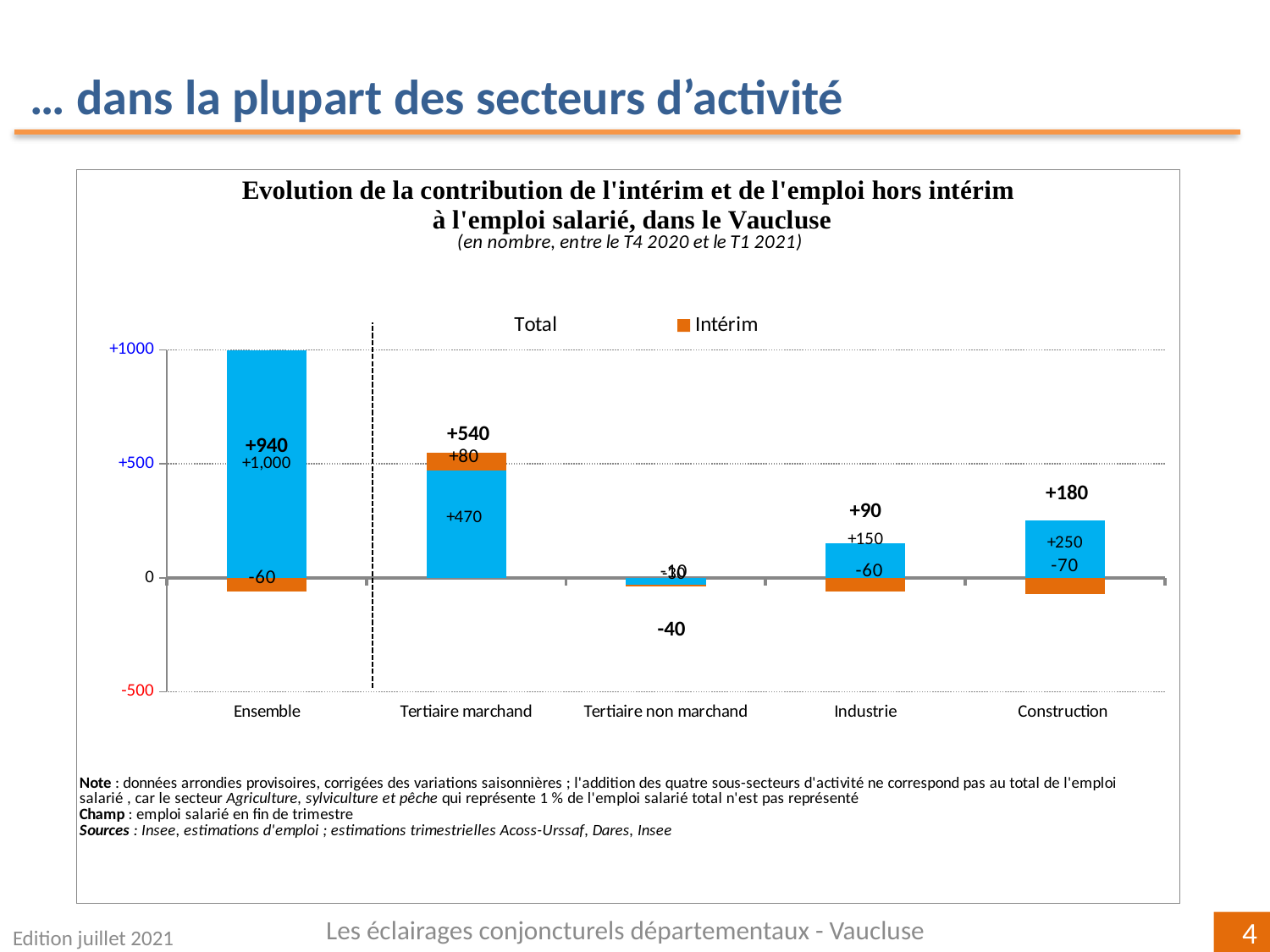
What is the total value shown for Ensemble? +940 Between which two quarters does the chart measure the change, according to its subtitle? T4 2020 and T1 2021 Which has the larger total value, Industrie or Construction? Construction What is the Intérim value for Industrie? -60 Among the four sub-sectors (excluding Ensemble), which has the highest total value? Tertiaire marchand What is the total value shown for Tertiaire non marchand? -40 What is the difference between the total for Construction and the total for Industrie? 90 What is the Intérim value for Tertiaire marchand? +80 What value is printed in the blue segment of the Construction bar? +250 What kind of chart is shown on the slide? Bar chart Which category has the lowest total value? Tertiaire non marchand How many categories are shown on the x axis? 5